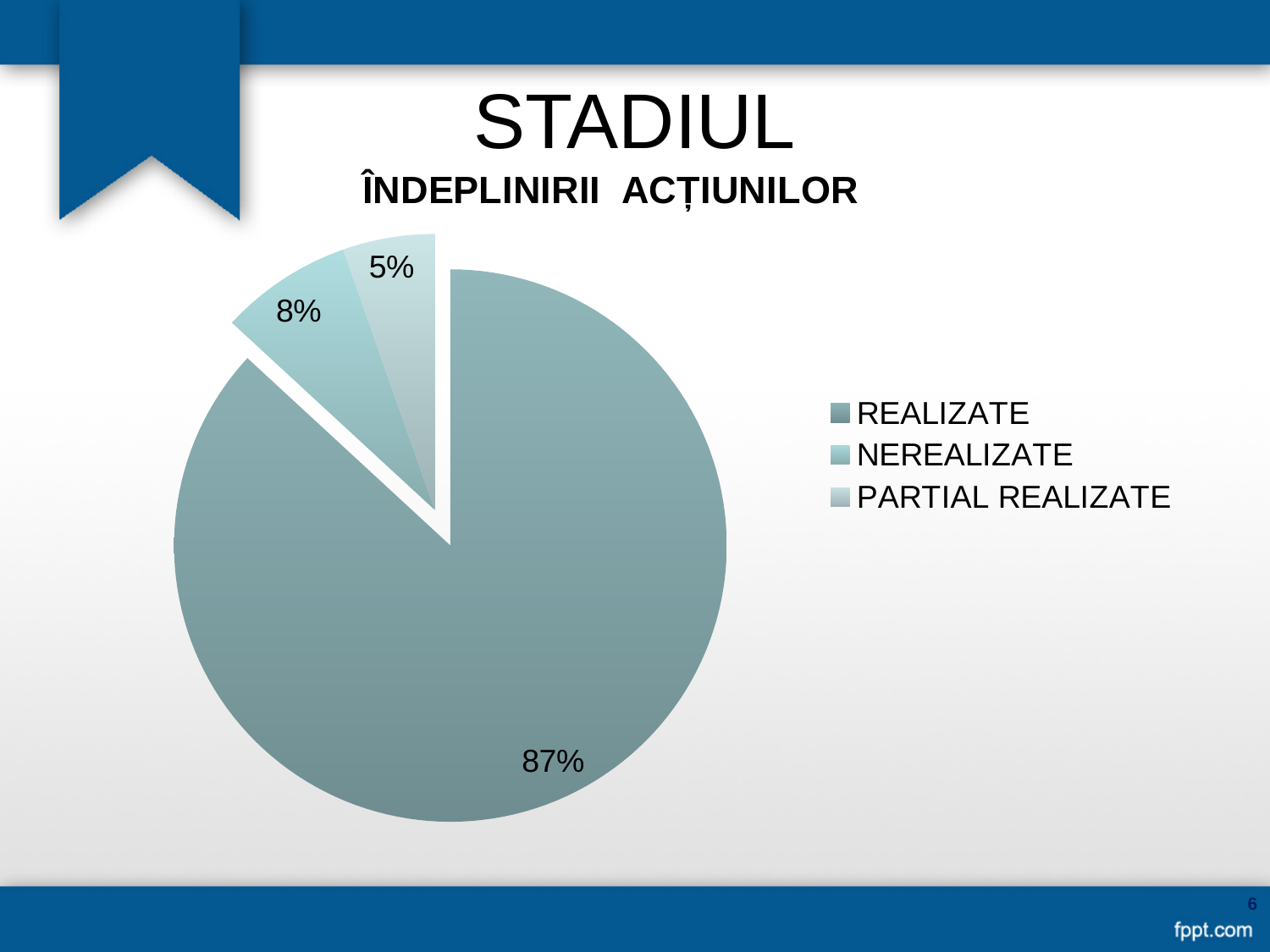
Which category has the smallest slice of the pie? PARTIAL REALIZATE How many categories does the pie chart have? 3 What share of the pie does NEREALIZATE represent? 8% What is the title shown above the chart? STADIUL ÎNDEPLINIRII ACȚIUNILOR What share of the pie does PARTIAL REALIZATE represent? 5% How many entries does the legend list? 3 Which category has the largest slice of the pie? REALIZATE What share of the pie does REALIZATE represent? 87% Which is larger, the NEREALIZATE slice or the PARTIAL REALIZATE slice? NEREALIZATE What is the difference in percentage points between NEREALIZATE and PARTIAL REALIZATE? 3 What kind of chart is shown on the slide? pie chart What is the difference in percentage points between REALIZATE and NEREALIZATE? 79